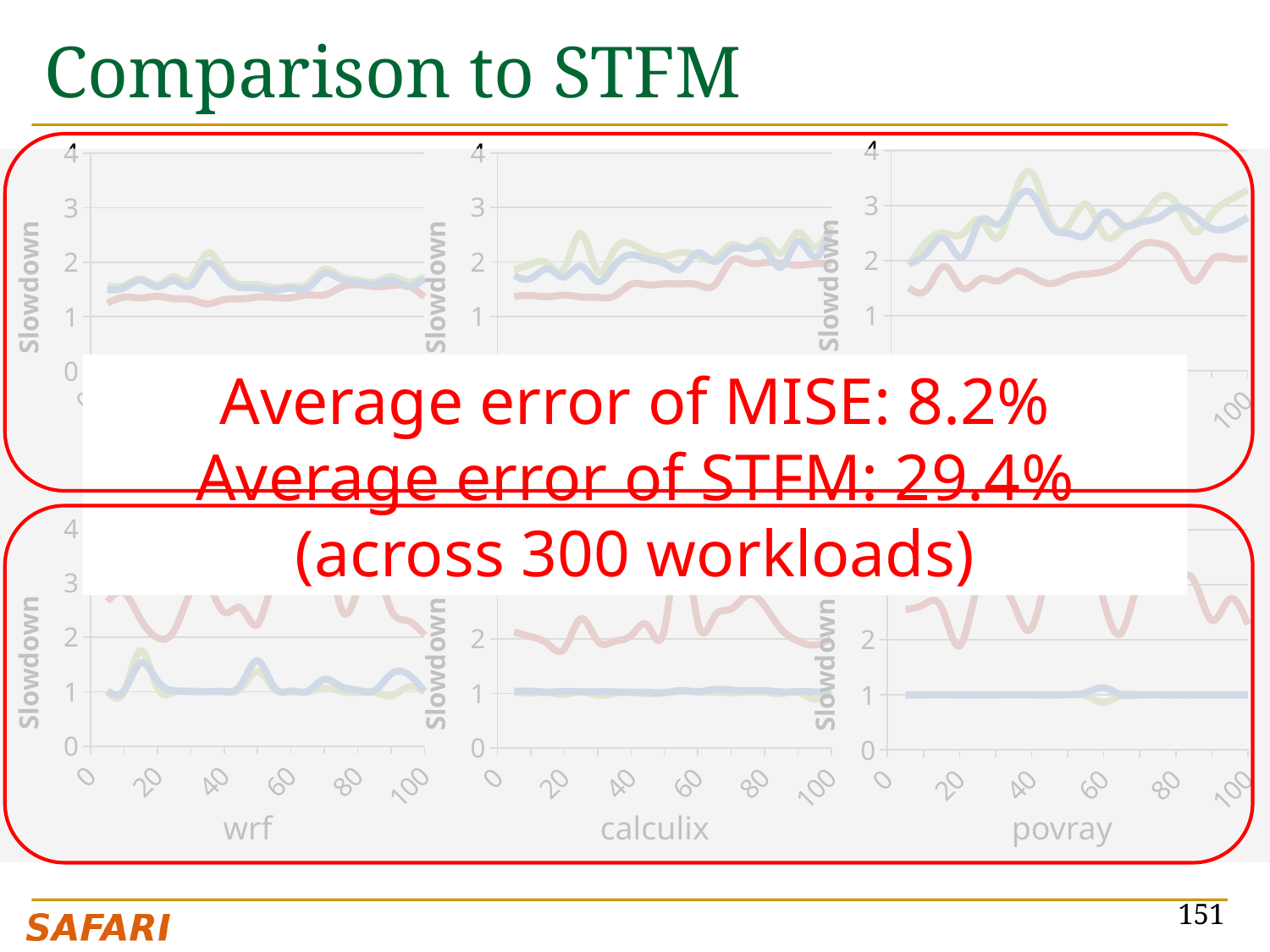
How many chart panels are shown on the slide? 6 In the top-left chart, is the blue line's value at x = 20 greater or less than 3? less What is the highest tick value shown on the y-axis of the charts? 4 What is the y-axis label on the charts? Slowdown In the bottom-right chart (povray), is the blue line's value at x = 40 greater or less than 2? less What is the x-axis title of the bottom-left chart? wrf In the bottom-left chart (wrf), is the red line's value at x = 40 greater or less than 1? greater What kind of chart is used in each of the panels on the slide? line chart